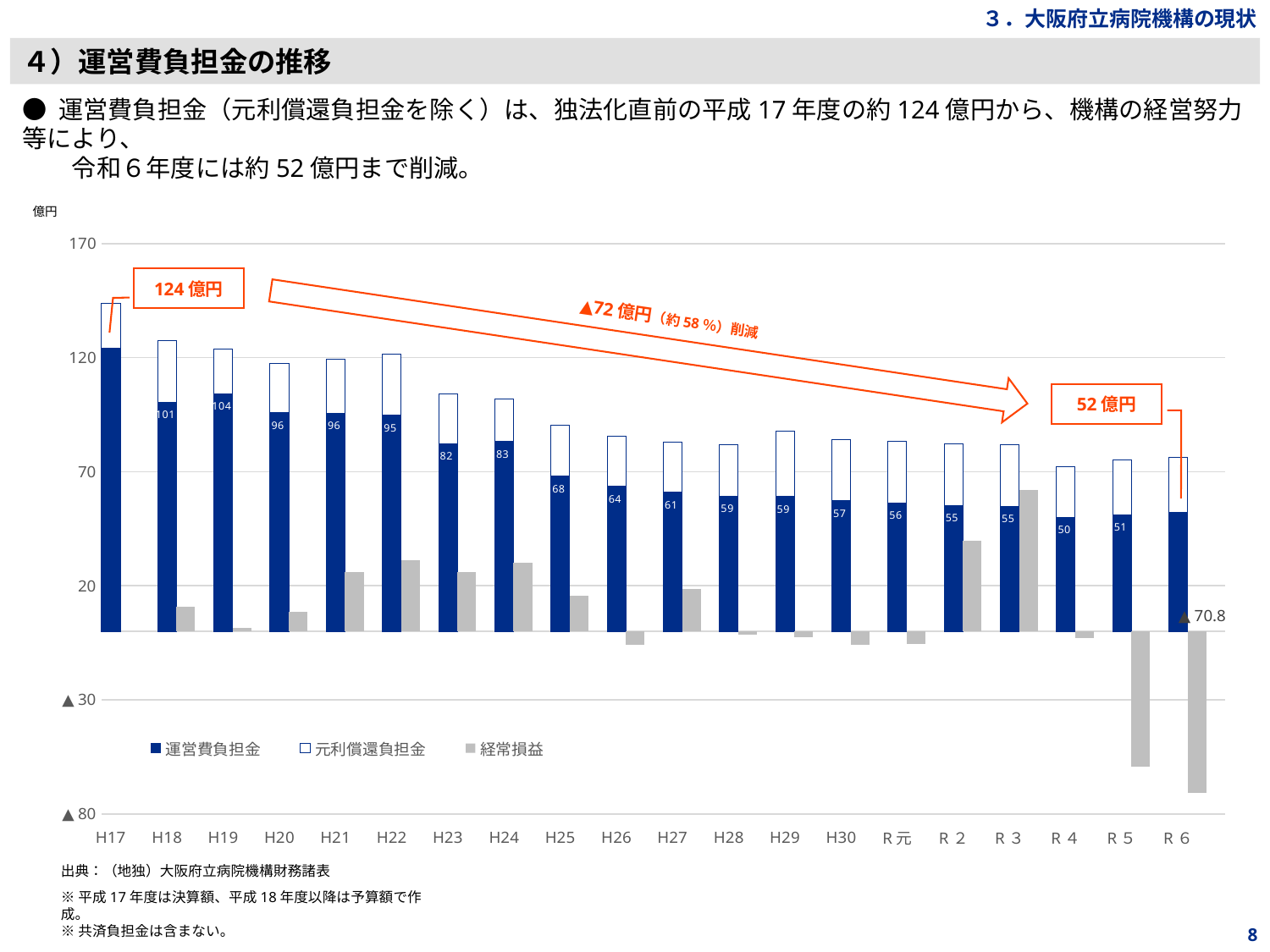
How many fiscal years are shown on the x axis? 20 Which year has the highest 運営費負担金 value? H17 What is the difference between the 運営費負担金 values for H17 (124) and R6 (52)? 72 What is the value of 運営費負担金 for R4? 50 What kind of chart is shown on the slide? bar chart Which year has the lowest 運営費負担金 value? R4 Which is larger, the 運営費負担金 value for H18 or for H19? H19 Does the 運営費負担金 value generally rise or fall from H17 to R6? fall Is the 経常損益 value for R6 greater or less than ▲30? less What is the value of 運営費負担金 for H25? 68 What is the value of 運営費負担金 for H18? 101 How many series does the legend list? 3